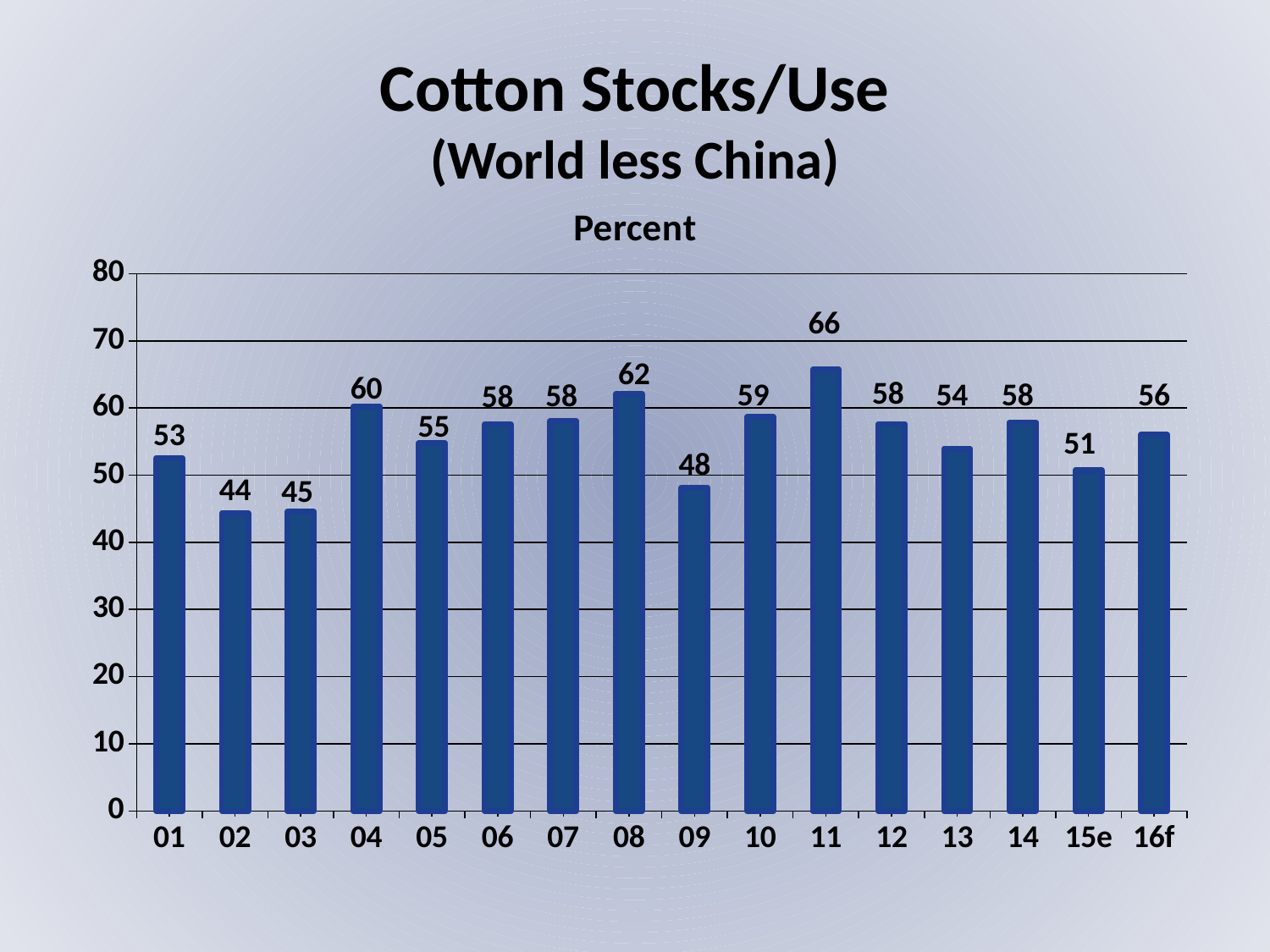
Which year has the lowest stocks/use value? 02 What kind of chart is shown on the slide? bar chart What is the difference between the values for 11 and 02? 22 What is the title of the chart? Cotton Stocks/Use (World less China) What is the value shown for 09? 48 What is the value shown for 15e? 51 What is the difference between the values for 08 and 09? 14 What is the cotton stocks/use value for 11? 66 Is the value for 13 greater or less than 50? greater How many bars are shown in the chart? 16 Which year has the highest stocks/use value? 11 Which is larger, the value for 04 or the value for 05? 04